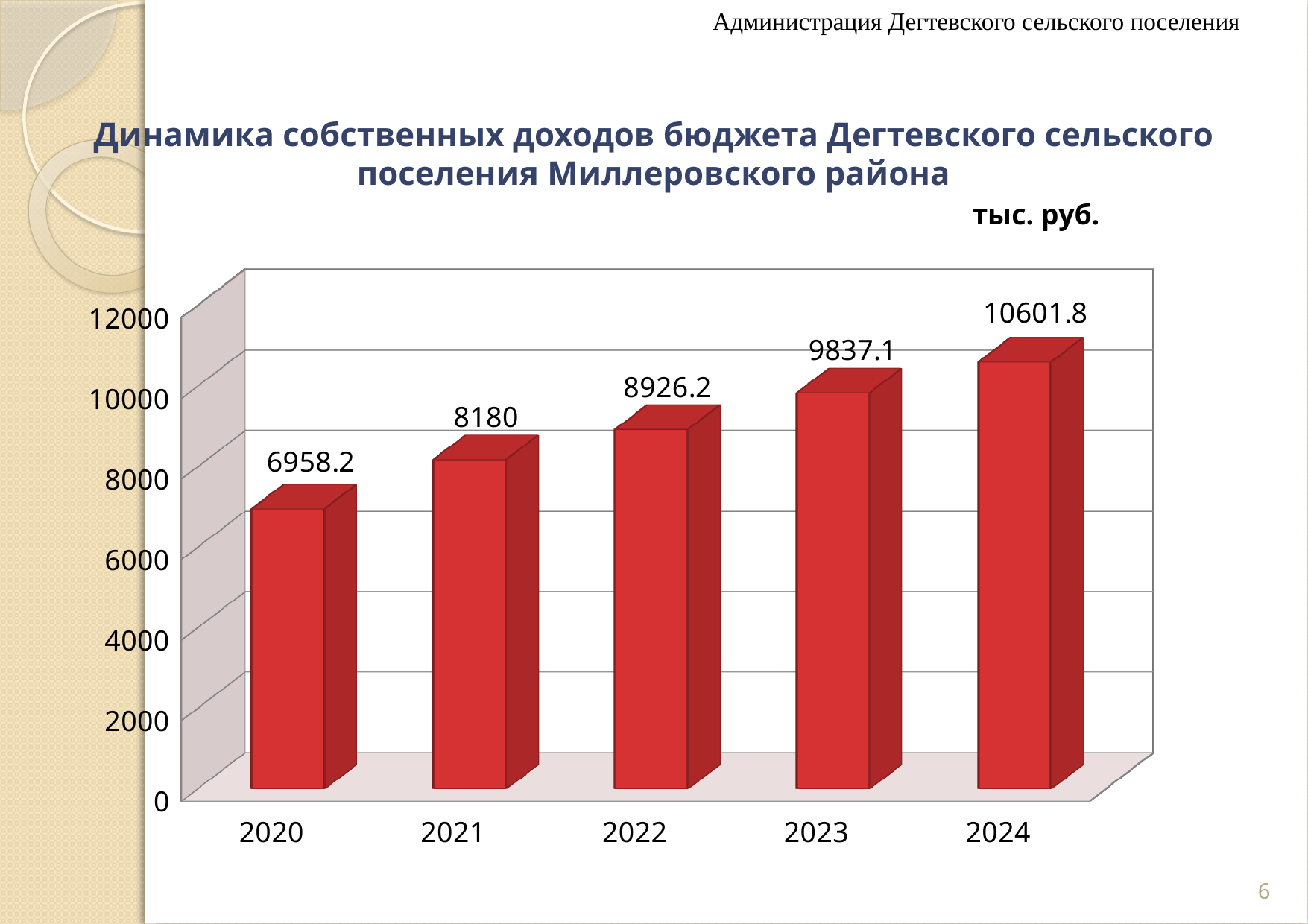
Which is larger, the value for 2021 or the value for 2022? 2022 What is the value for 2020? 6958.2 Do the values rise or fall from 2020 to 2024? rise How many years are shown on the chart? 5 What kind of chart is shown on the slide? bar chart Which year has the highest value? 2024 What is the difference between the values for 2024 and 2023? 764.7 What is the value for 2022? 8926.2 Is the value for 2023 greater or less than 8000? greater What is the difference between the values for 2021 and 2020? 1221.8 Which year has the lowest value? 2020 What is the value for 2024? 10601.8